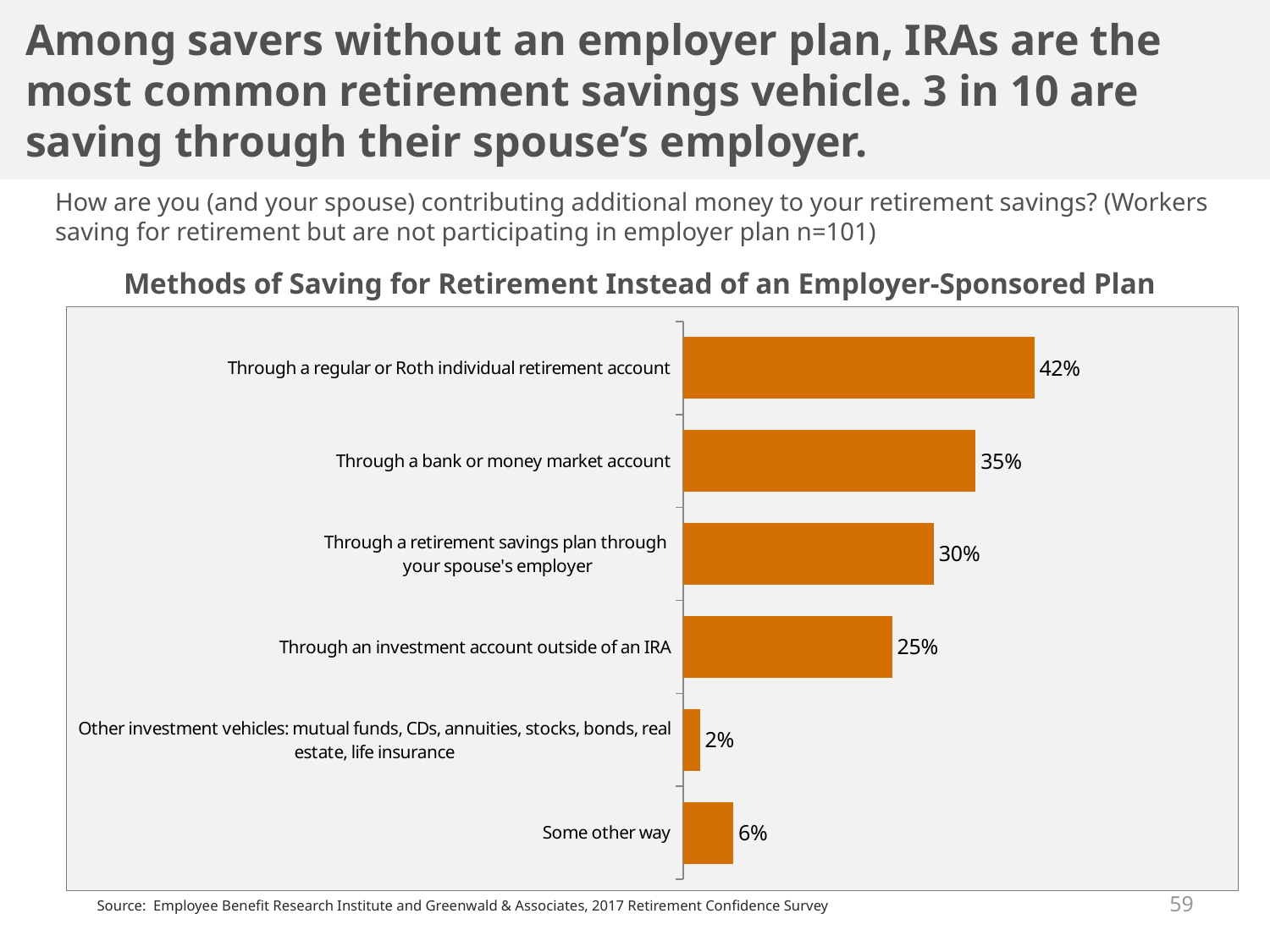
Which method of saving has the lowest percentage? Other investment vehicles: mutual funds, CDs, annuities, stocks, bonds, real estate, life insurance What is the difference in percentage points between saving through a regular or Roth IRA and saving through a bank or money market account? 7 How many methods of saving are shown in the chart? 6 Which method of saving has the highest percentage? Through a regular or Roth individual retirement account What type of chart is shown on the slide? Bar chart What percentage of savers contribute through a retirement savings plan through their spouse's employer? 30% What percentage of savers contribute through a regular or Roth individual retirement account? 42% What is the title of the chart? Methods of Saving for Retirement Instead of an Employer-Sponsored Plan What percentage of savers contribute through an investment account outside of an IRA? 25% What percentage of savers contribute through a bank or money market account? 35% Which is larger: the percentage saving through an investment account outside of an IRA or the percentage saving some other way? Through an investment account outside of an IRA What percentage of savers contribute through some other way? 6%